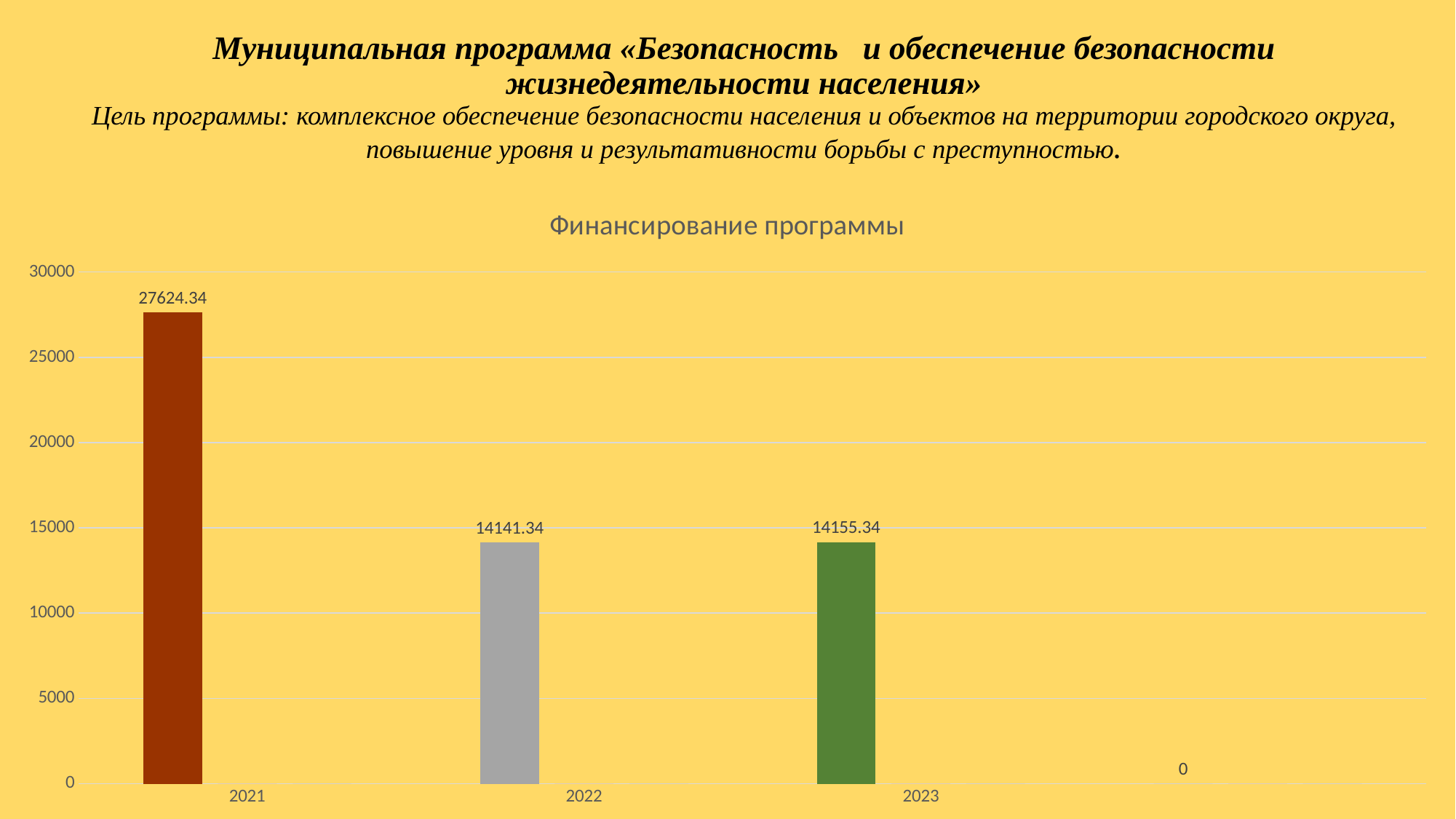
What is the difference between the values for 2021 and 2022? 13483 How many years are labeled on the x axis of the chart? 3 What is the value for 2022 in the chart? 14141.34 What is the difference between the values for 2023 and 2022? 14 What is the value for 2023 in the chart? 14155.34 Does the value rise or fall from 2021 to 2022? fall What kind of chart is shown on the slide? bar chart Which year has the highest value in the chart? 2021 Is the value for 2022 greater or less than 15000? less Which is larger, the value for 2021 or the value for 2023? 2021 What is the value for 2021 in the chart "Финансирование программы"? 27624.34 Is the value for 2021 greater or less than 25000? greater